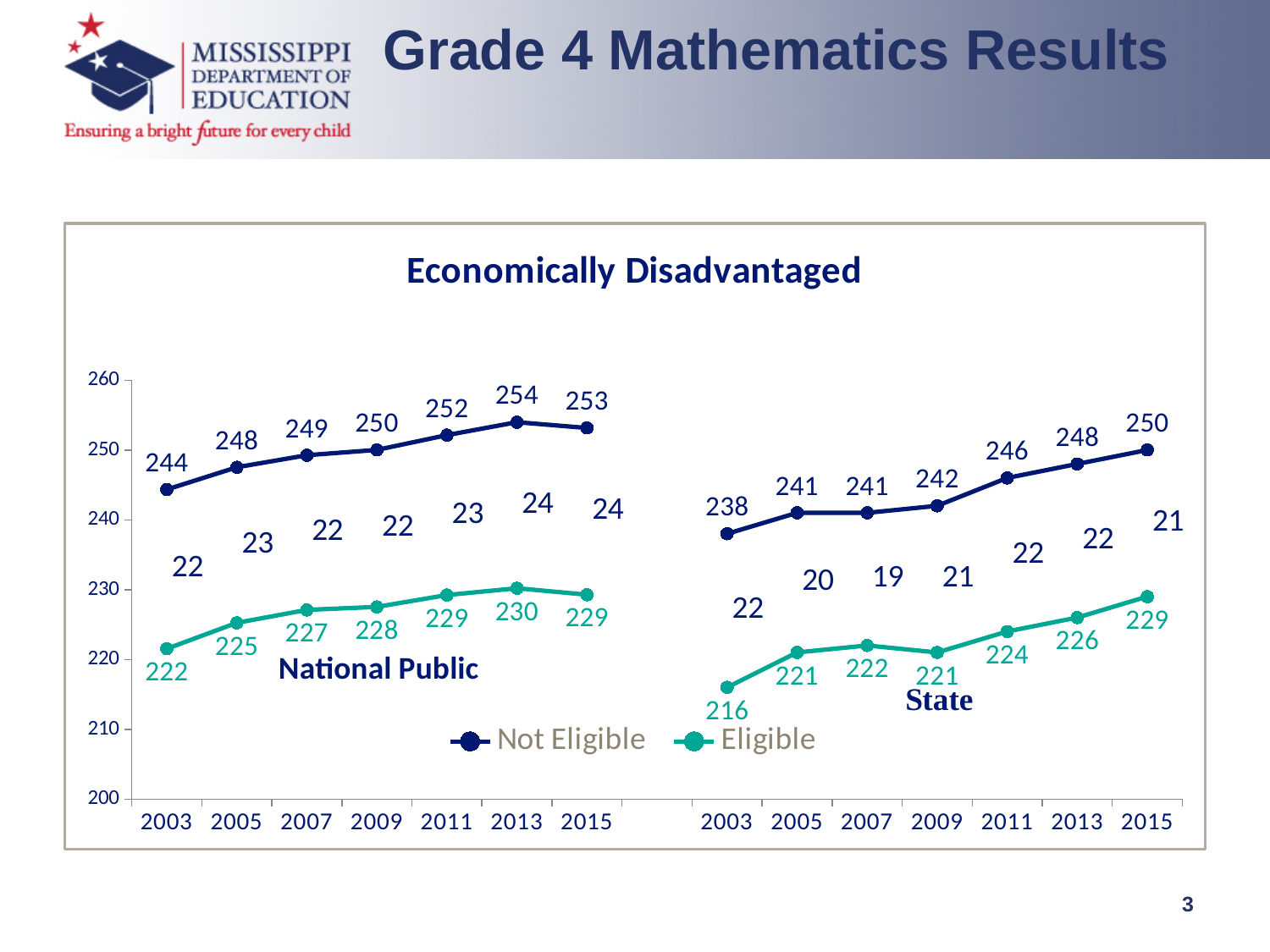
In which year is the Eligible value for State lowest? 2003 Does the Not Eligible value for State rise or fall from 2003 to 2015? Rise In which year is the Not Eligible value for National Public highest? 2013 Which is larger, the Eligible value for National Public in 2015 or the Eligible value for State in 2015? They are equal (229) What is the Not Eligible value for State in 2015? 250 What kind of chart is shown on the slide? Line chart What is the Not Eligible value for National Public in 2013? 254 How many series does the legend list? 2 What is the Eligible value for State in 2003? 216 What is the title of the chart? Economically Disadvantaged What is the Eligible value for National Public in 2007? 227 What is the difference between the Not Eligible and Eligible values for State in 2015? 21